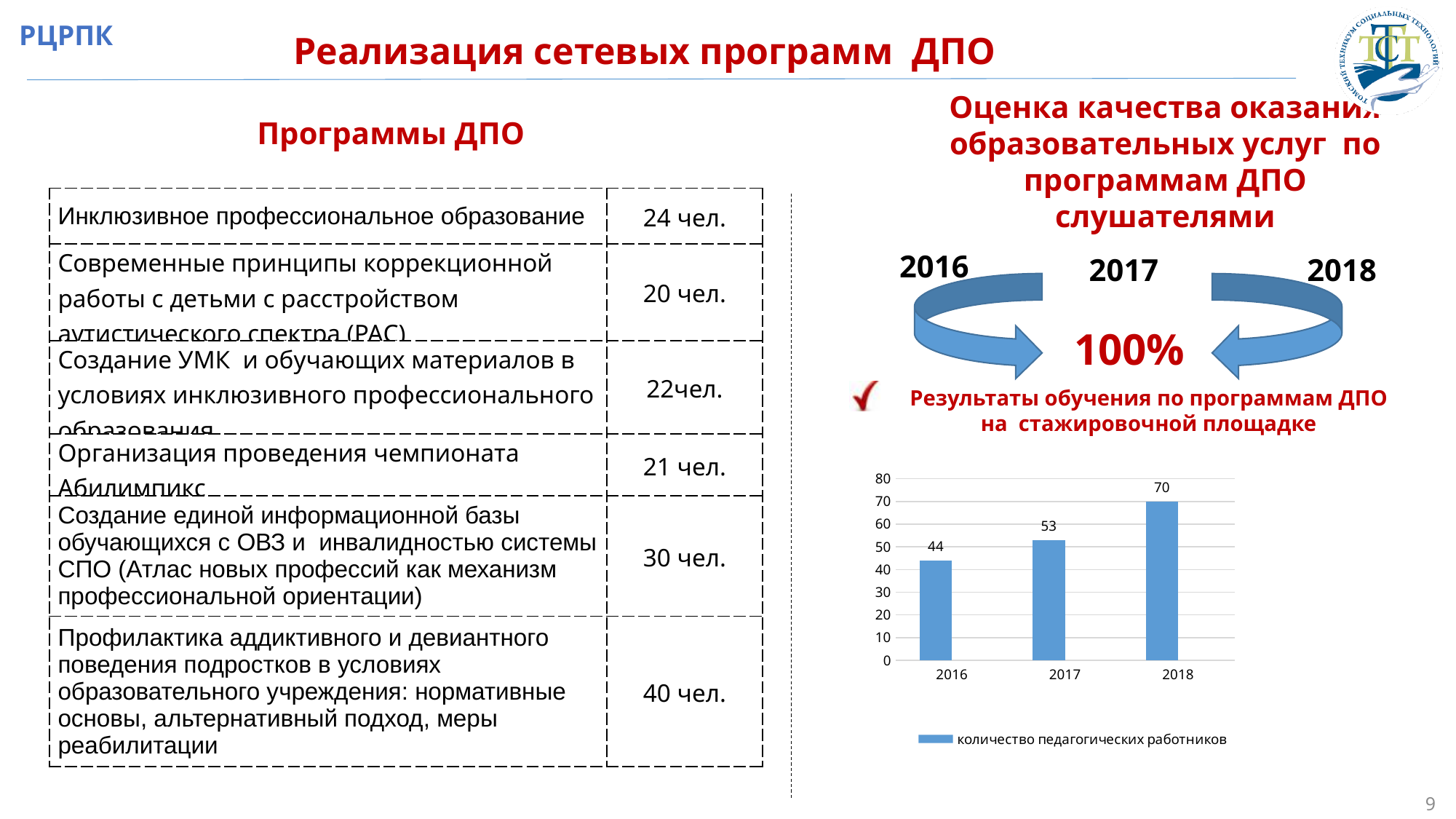
What is the difference between the values for 2017 and 2016 in the bar chart? 9 Do the values in the bar chart rise or fall from 2016 to 2018? rise What is the value for 2018 in the bar chart? 70 What is the difference between the values for 2018 and 2016 in the bar chart? 26 Which is larger in the bar chart, the value for 2017 or the value for 2018? 2018 Which year has the lowest value in the bar chart? 2016 Is the value for 2017 in the bar chart greater or less than 60? less What kind of chart is shown on the slide? bar chart Which year has the highest value in the bar chart? 2018 What is the value for 2017 in the bar chart? 53 How many years are shown on the x axis of the bar chart? 3 What is the value for 2016 in the bar chart? 44